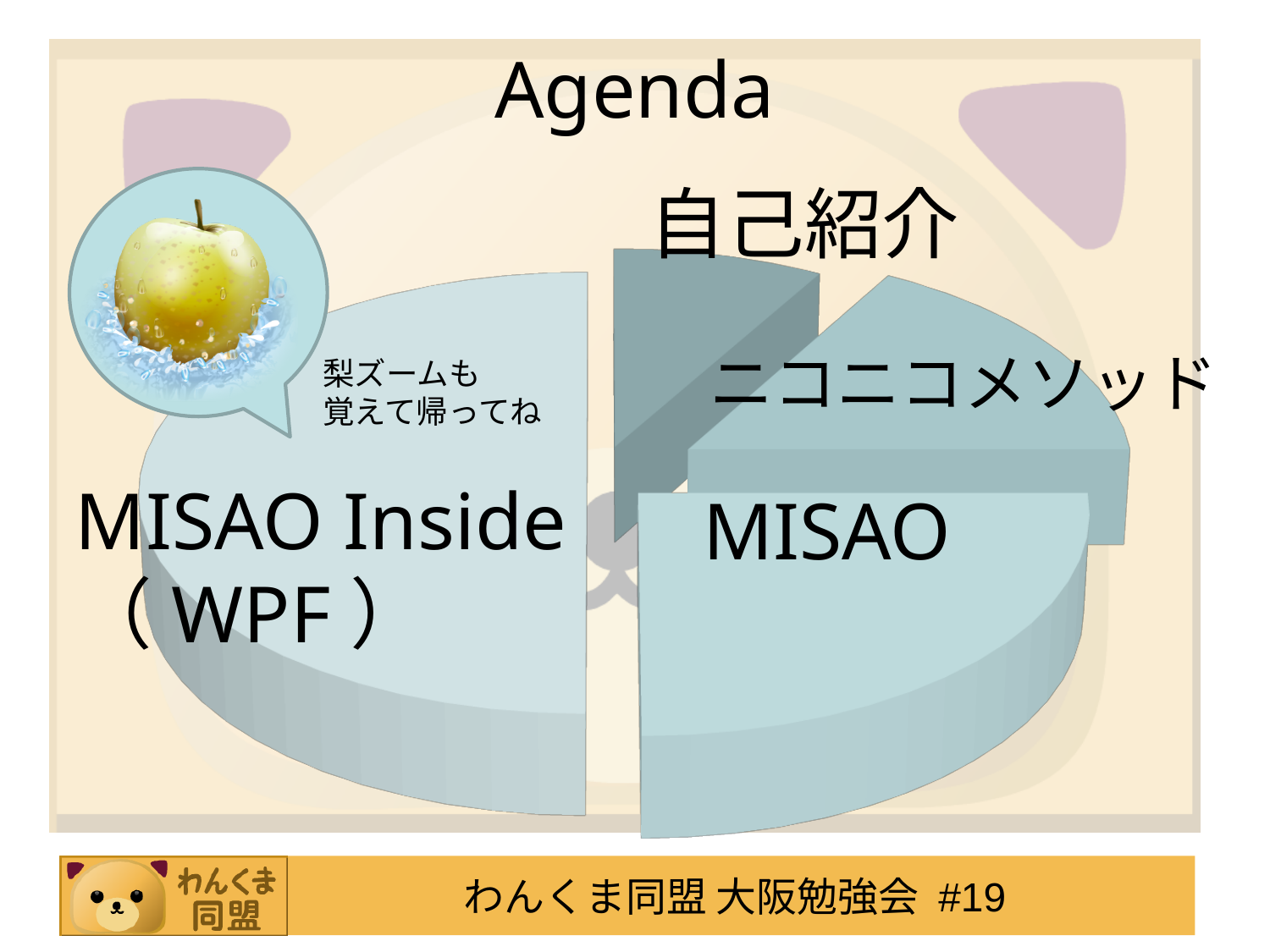
What kind of chart is shown on the slide? pie chart Which slice is larger, MISAO Inside（WPF） or MISAO? MISAO Inside（WPF） Which slice of the pie chart is the largest? MISAO Inside（WPF） Which slice is larger, MISAO Inside（WPF） or 自己紹介? MISAO Inside（WPF） What is the title of the chart on the slide? Agenda Which slice of the pie chart is the smallest? 自己紹介 How many slices does the pie chart have? 4 Which slice is larger, MISAO or ニコニコメソッド? MISAO